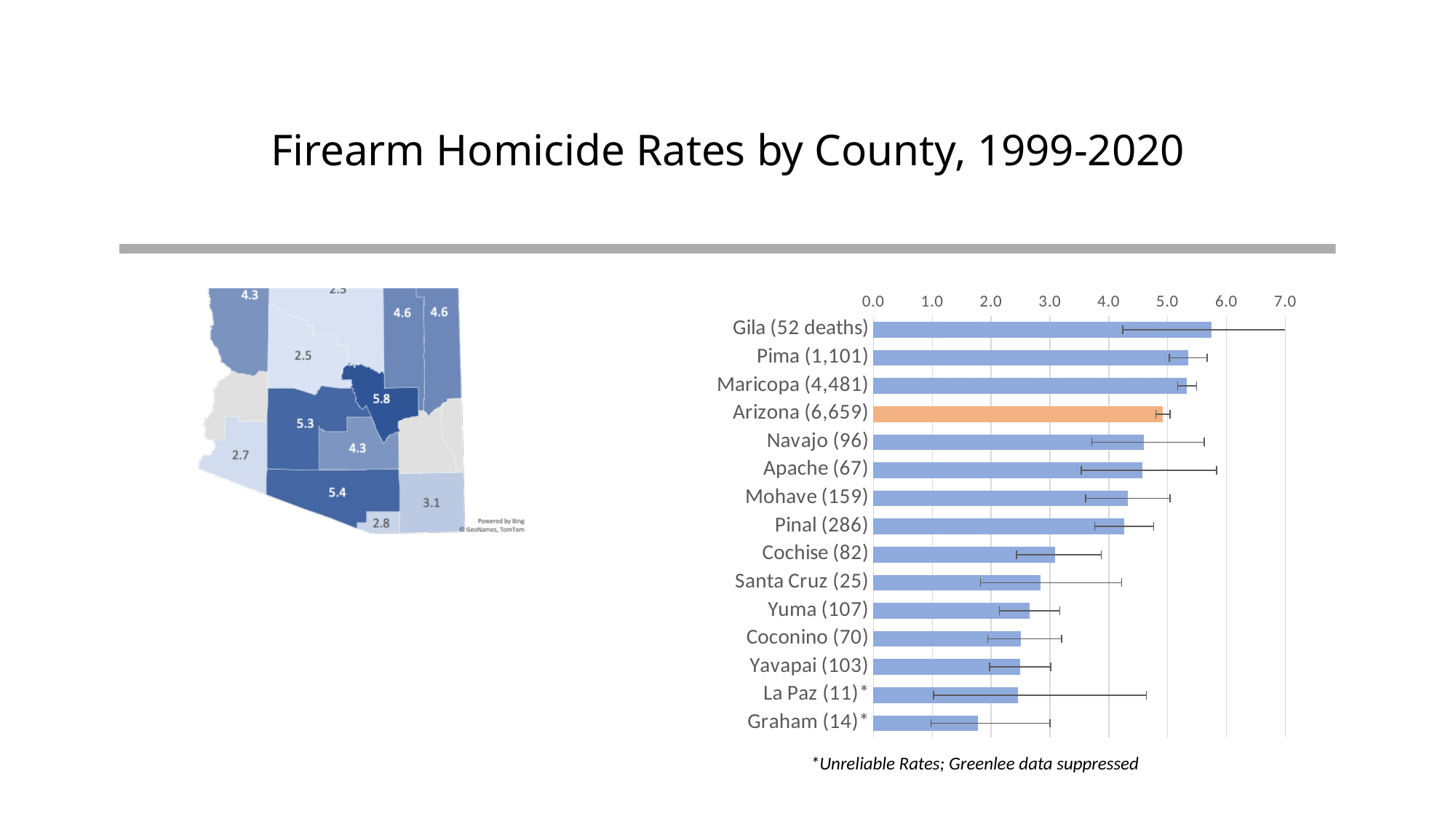
How many bars are plotted in the bar chart? 15 Is the value for Yuma (107) greater or less than 3.0? less Is the value for Maricopa (4,481) greater or less than 5.0? greater Is the value for Graham (14)* greater or less than 2.0? less Which bar in the bar chart is coloured orange rather than blue? Arizona (6,659) Which category has the lowest firearm homicide rate in the bar chart? Graham (14)* Which has the larger firearm homicide rate, Pima (1,101) or Yuma (107)? Pima (1,101) What kind of chart is shown on the right side of the slide? bar chart Which category has the highest firearm homicide rate in the bar chart? Gila (52 deaths) According to the footnote, what does the asterisk next to La Paz and Graham indicate? Unreliable Rates